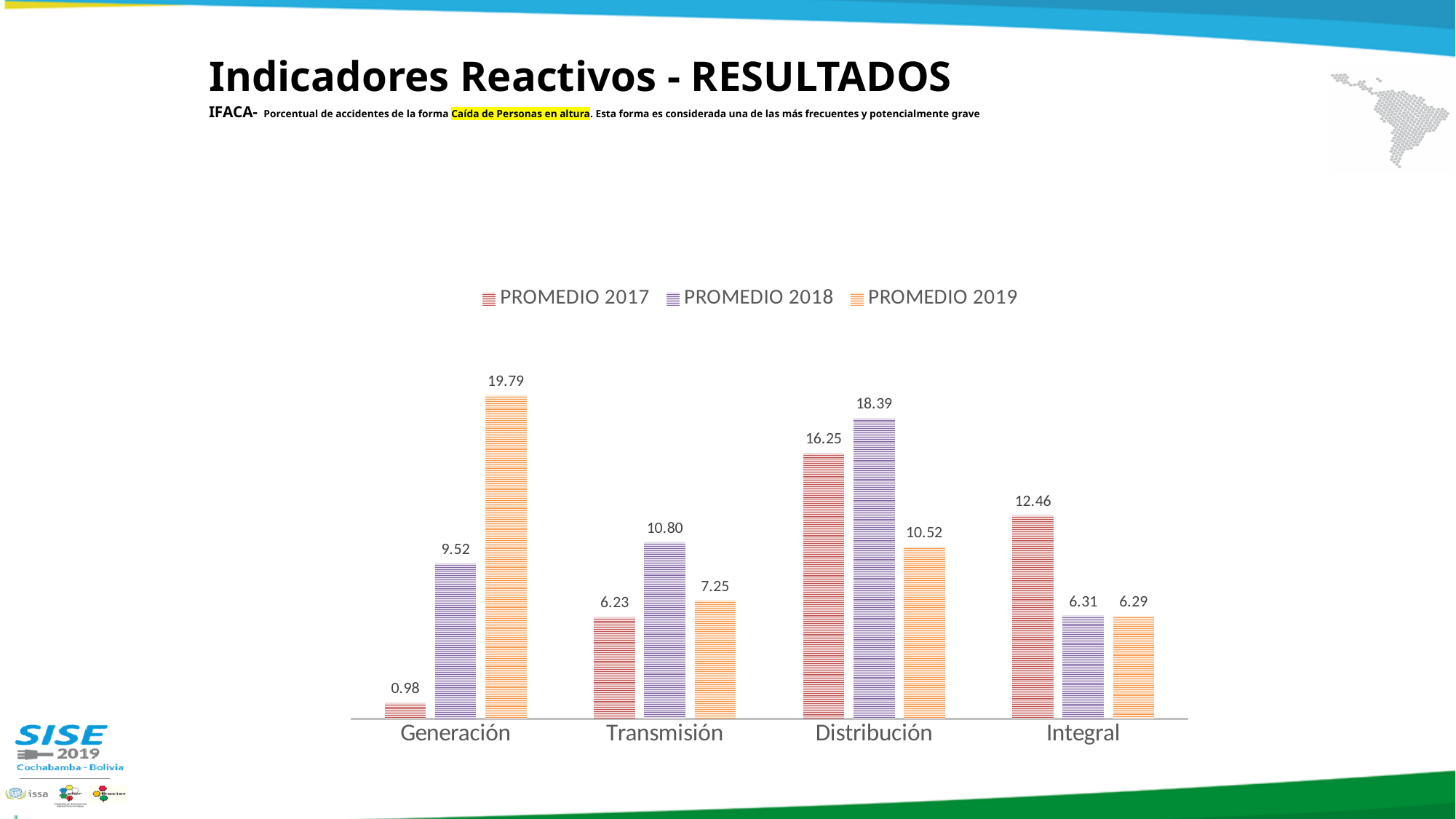
Which category has the highest PROMEDIO 2017 value? Distribución How many categories are shown on the x axis? 4 What is the difference between the PROMEDIO 2018 and PROMEDIO 2017 values for Generación? 8.54 Which category has the lowest PROMEDIO 2019 value? Integral What kind of chart is shown on the slide? Bar chart Which is larger for Distribución: PROMEDIO 2018 or PROMEDIO 2019? PROMEDIO 2018 What is the PROMEDIO 2018 value for Transmisión? 10.80 What is the PROMEDIO 2019 value for Generación? 19.79 What is the difference between the PROMEDIO 2017 values for Integral and Transmisión? 6.23 How many series does the legend list? 3 What is the PROMEDIO 2017 value for Distribución? 16.25 Do the PROMEDIO 2019 values rise or fall from Distribución to Integral? Fall